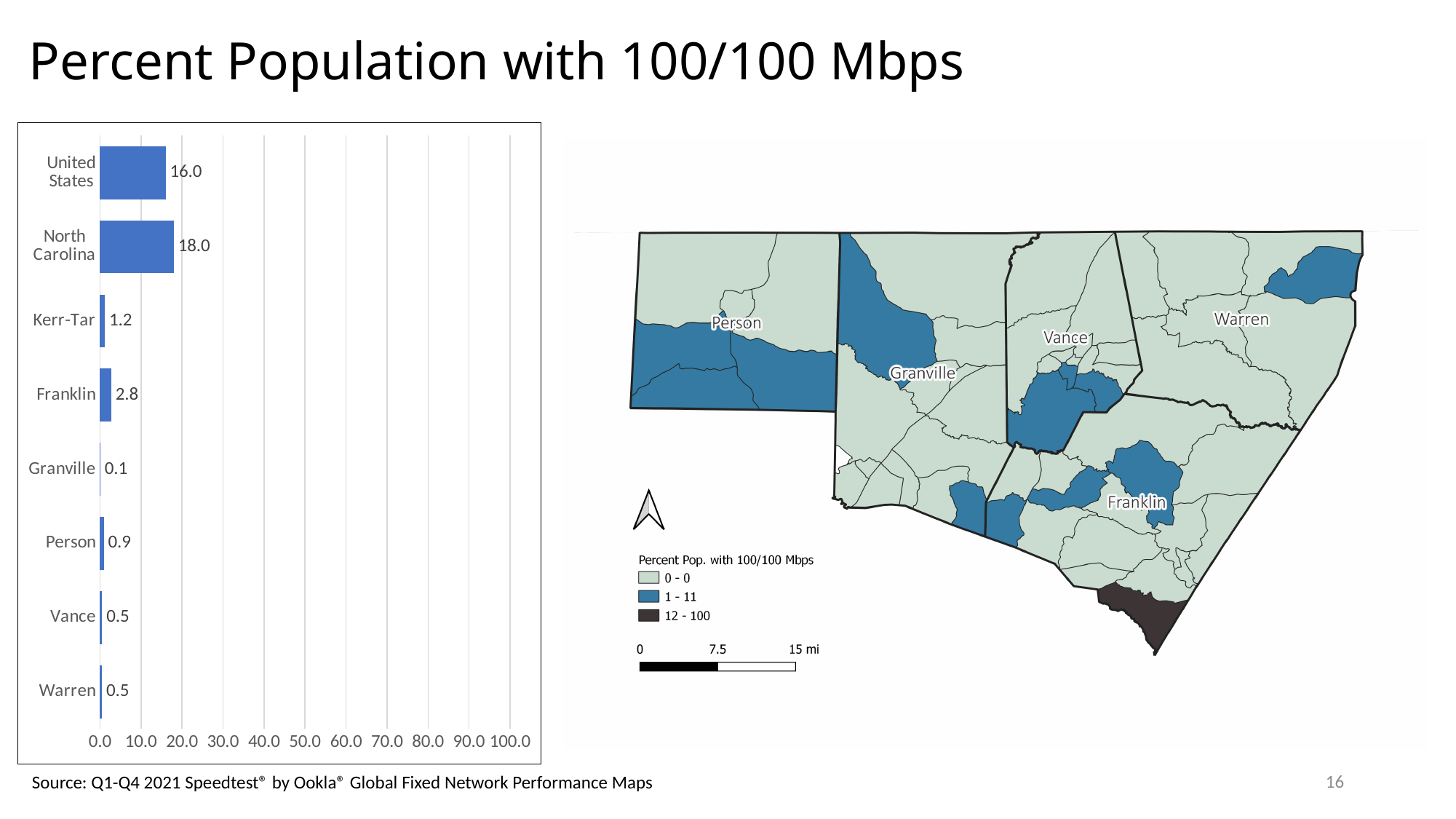
Which has a larger value in the bar chart, Franklin or Kerr-Tar? Franklin What kind of chart is shown on the left of the slide? Bar chart What is the maximum value shown on the x axis of the bar chart? 100.0 What is the value for North Carolina in the bar chart? 18.0 Is the value for the United States in the bar chart greater or less than 10.0? greater Which category has the lowest value in the bar chart? Granville What is the difference between the values for Franklin and Person in the bar chart? 1.9 What is the difference between the values for North Carolina and the United States in the bar chart? 2.0 What is the value for Kerr-Tar in the bar chart? 1.2 How many categories are shown in the bar chart? 8 Which category has the highest value in the bar chart? North Carolina What is the value for Granville in the bar chart? 0.1